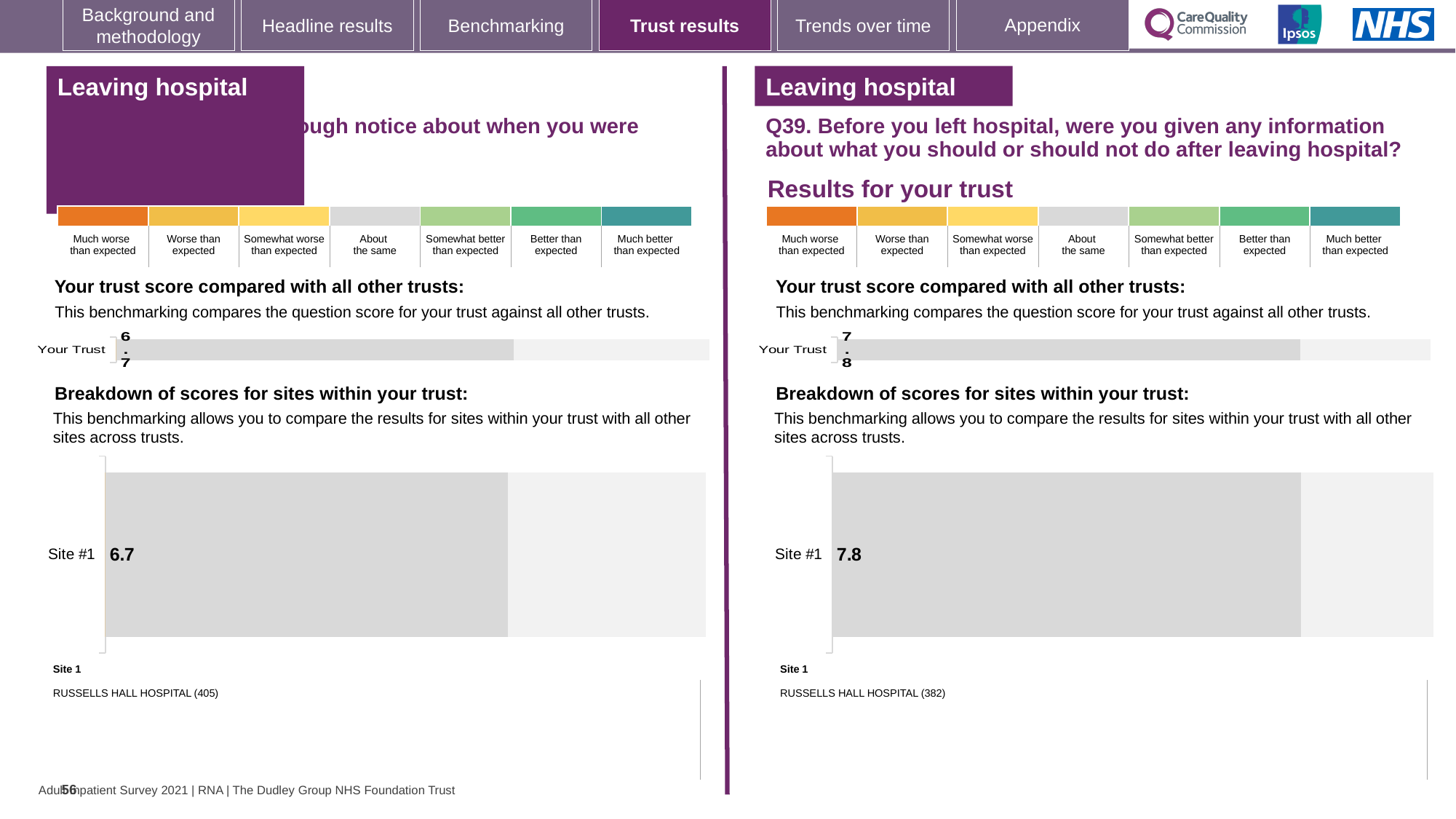
Which hospital is listed as Site 1 beneath the right-hand (Q39) breakdown chart? RUSSELLS HALL HOSPITAL (382) Which hospital is listed as Site 1 beneath the left-hand breakdown chart? RUSSELLS HALL HOSPITAL (405) On the right-hand (Q39) breakdown chart, is the Site #1 score greater or less than 7? greater On the left-hand 'Breakdown of scores for sites within your trust' chart, what is the score for Site #1? 6.7 Is the Site #1 score higher on the left-hand breakdown chart or on the right-hand (Q39) breakdown chart? the right-hand (Q39) chart How many bars are plotted on the left-hand 'Your trust score compared with all other trusts' chart? 1 On the right-hand (Q39) 'Your trust score compared with all other trusts' chart, what is the score shown for Your Trust? 7.8 On the left-hand 'Your trust score compared with all other trusts' chart, what is the score shown for Your Trust? 6.7 What kind of chart is used for the 'Breakdown of scores for sites within your trust' on the right-hand (Q39) side? bar chart How many sites are plotted on the right-hand (Q39) 'Breakdown of scores for sites within your trust' chart? 1 What is the difference between the Site #1 score on the right-hand (Q39) breakdown chart and the Site #1 score on the left-hand breakdown chart? 1.1 On the right-hand (Q39) 'Breakdown of scores for sites within your trust' chart, what is the score for Site #1? 7.8